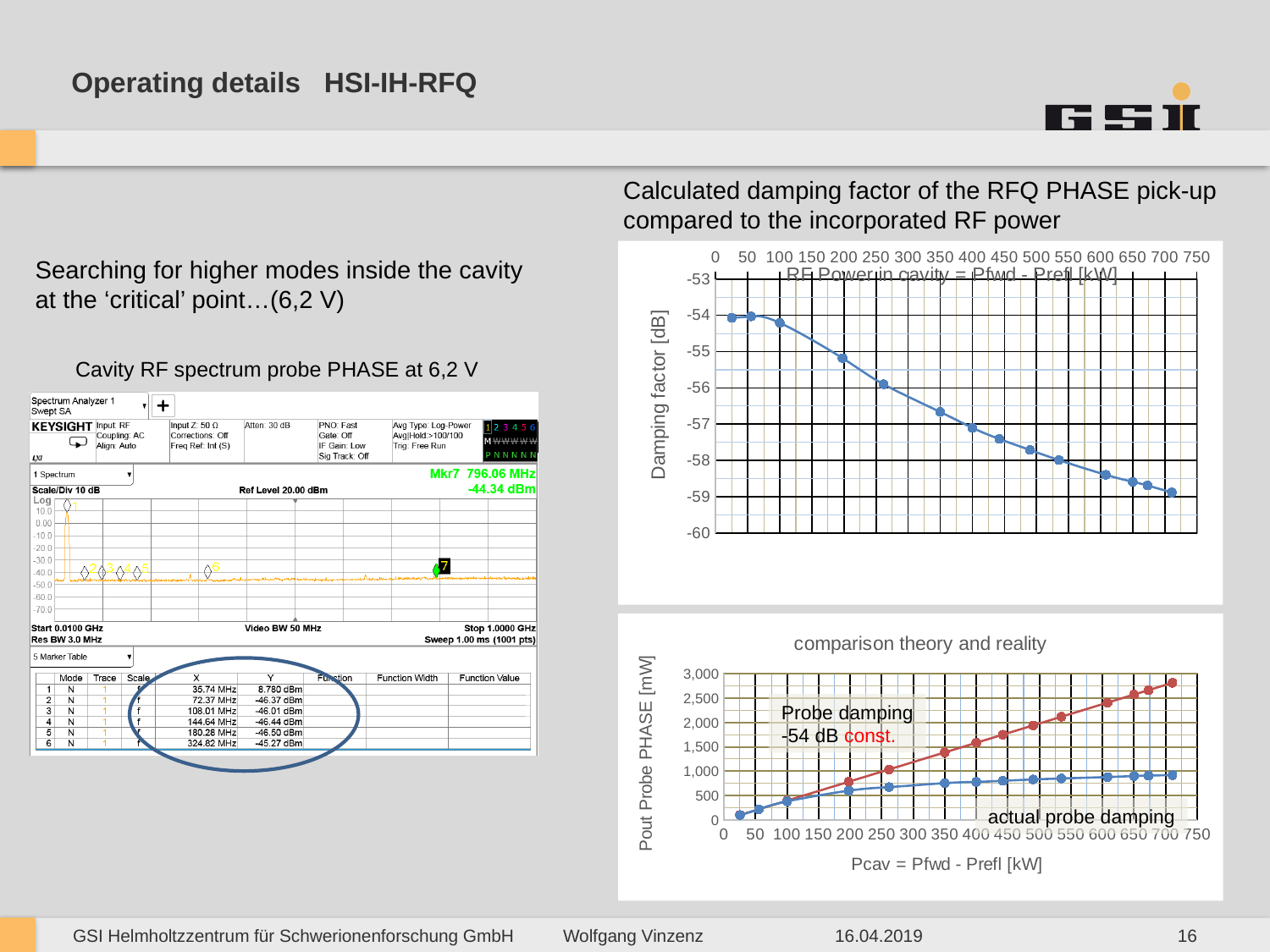
In the 'comparison theory and reality' chart (bottom right), how many data series are plotted? 2 In the 'comparison theory and reality' chart (bottom right), what is the label of the x axis? Pcav = Pfwd - Prefl [kW] In the 'comparison theory and reality' chart (bottom right), is the 'actual probe damping' value at 700 kW greater or less than 1,000 mW? less In the 'comparison theory and reality' chart (bottom right), which series has the larger value at 700 kW: 'Probe damping -54 dB const.' or 'actual probe damping'? Probe damping -54 dB const. In the 'Calculated damping factor' chart (top right), is the damping factor at 100 kW greater or less than -55 dB? greater In the spectrum analyzer screenshot (left), what is the X frequency listed for marker 3 in the marker table? 108.01 MHz In the 'Calculated damping factor' chart (top right), is the damping factor at 700 kW greater or less than -58 dB? less In the 'Calculated damping factor' chart (top right), do the damping factor values rise or fall as RF power increases along the x axis? fall In the 'Calculated damping factor' chart (top right), what is the label of the y axis? Damping factor [dB] In the 'Calculated damping factor' chart (top right), what kind of chart is it? line chart In the spectrum analyzer screenshot (left), what is the Y value listed for marker 6 in the marker table? -45.27 dBm